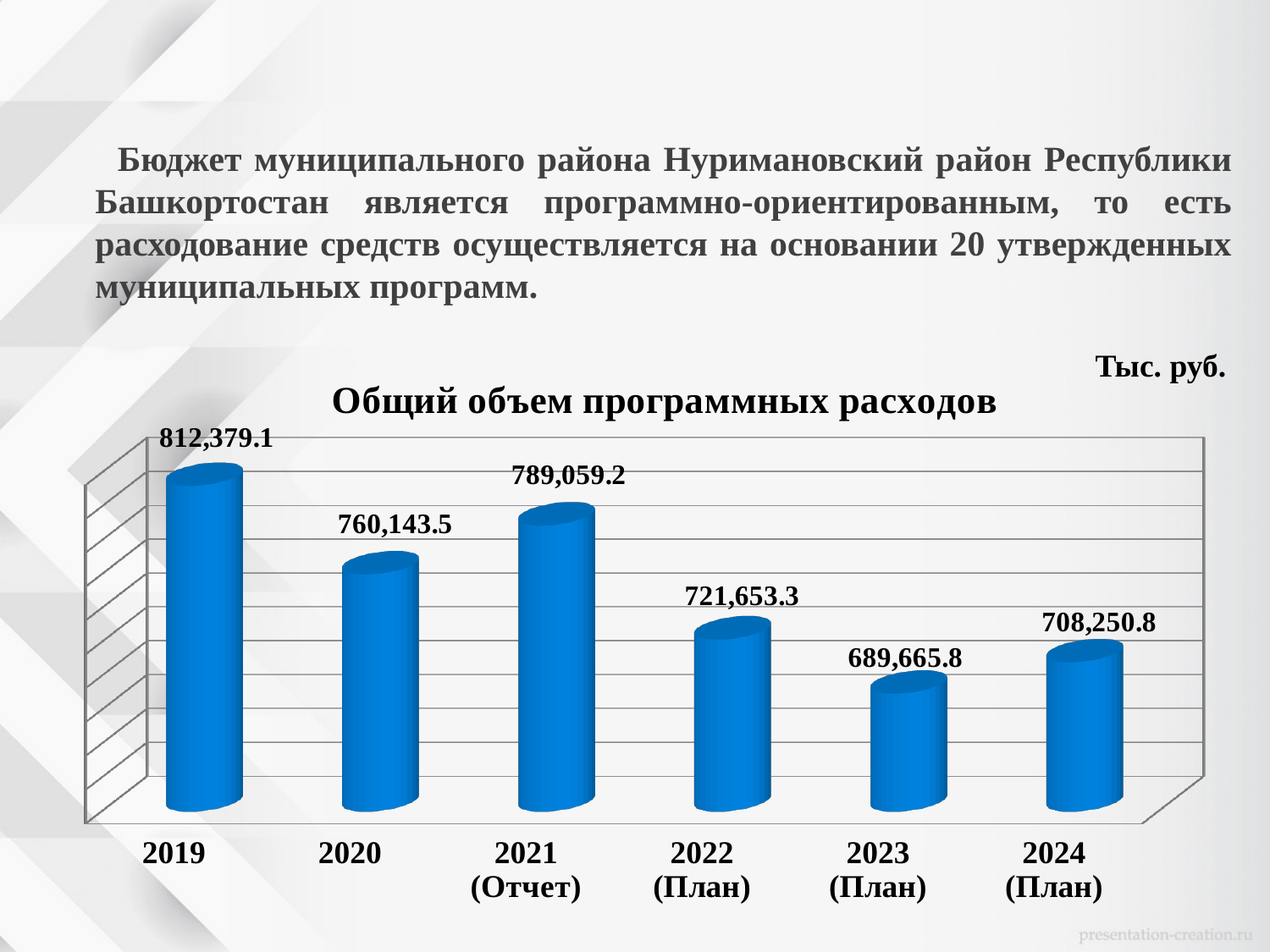
Which year has the highest value in the chart? 2019 Which is larger, the value for 2023 (План) or the value for 2024 (План)? 2024 (План) Which year has the lowest value in the chart? 2023 (План) What is the difference between the values for 2021 (Отчет) and 2022 (План)? 67,405.9 What kind of chart is shown on the slide? Bar chart What is the value for 2019 in the chart 'Общий объем программных расходов'? 812,379.1 How many years are shown in the chart? 6 Do the values rise or fall from 2021 (Отчет) to 2023 (План)? Fall What is the value for 2024 (План)? 708,250.8 What is the difference between the values for 2019 and 2020? 52,235.6 Which is larger, the value for 2020 or the value for 2021 (Отчет)? 2021 (Отчет) What is the value for 2022 (План)? 721,653.3